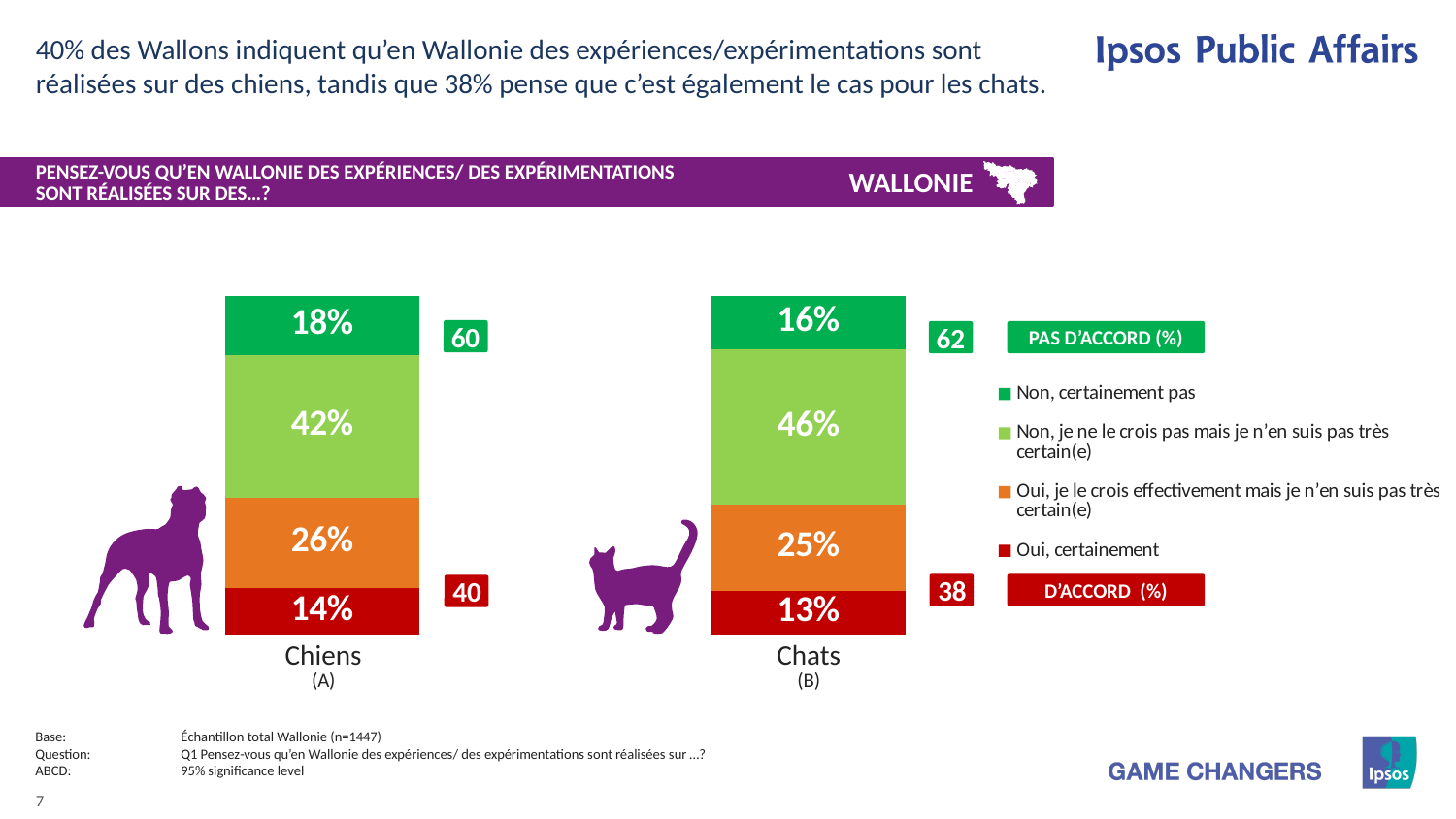
What is the difference between the "Oui, certainement" values for Chiens and Chats? 1% What is the total "Pas d'accord" percentage shown for Chats? 62 What is the total "D'accord" percentage shown for Chiens? 40 How many series does the legend list? 4 How many categories are shown on the x axis of the chart? 2 What is the value of the "Oui, je le crois effectivement mais je n'en suis pas très certain(e)" segment for Chiens? 26% What percentage of respondents answered "Oui, certainement" for Chiens? 14% What percentage of respondents answered "Non, certainement pas" for Chats? 16% Which category has the larger "Non, je ne le crois pas mais je n'en suis pas très certain(e)" segment, Chiens or Chats? Chats What is the difference between the "Non, certainement pas" values for Chiens and Chats? 2% What is the value of the "Non, je ne le crois pas mais je n'en suis pas très certain(e)" segment for Chats? 46% What kind of chart is shown on the slide? Stacked bar chart